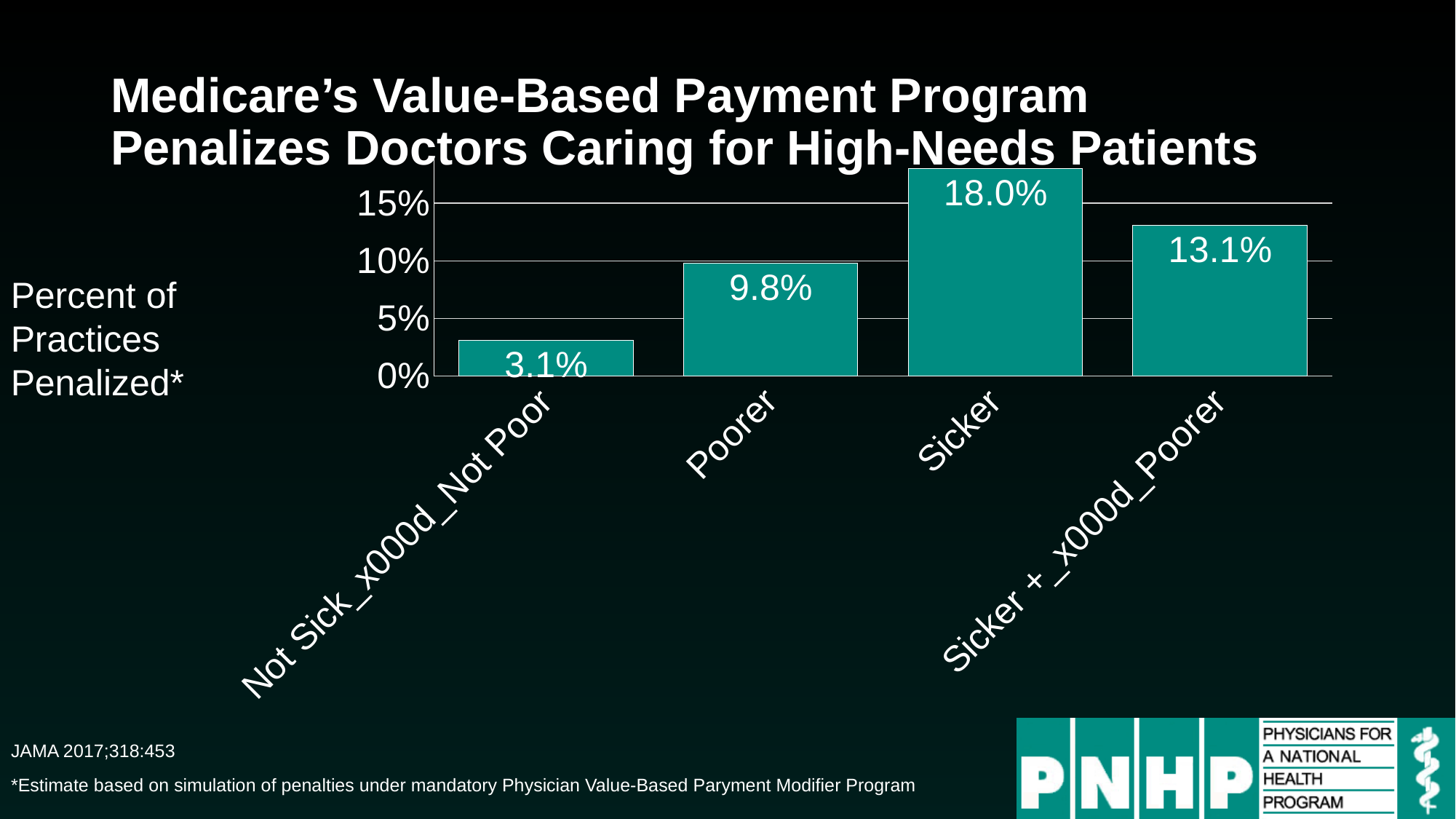
What is the value shown for the Sicker + Poorer category? 13.1% Which is larger, the value for Poorer or the value for Sicker + Poorer? Sicker + Poorer What is the difference between the Sicker value and the Poorer value? 8.2% What is the value shown for the Not Sick Not Poor category? 3.1% What is the difference between the Sicker + Poorer value and the Not Sick Not Poor value? 10.0% Which category has the lowest percent of practices penalized? Not Sick Not Poor Which category has the highest percent of practices penalized? Sicker How many categories are shown on the chart? 4 What percent of practices are penalized in the Sicker category? 18.0% What kind of chart is shown on the slide? bar chart What percent of practices are penalized in the Poorer category? 9.8% Is the value for Sicker greater or less than 15%? greater